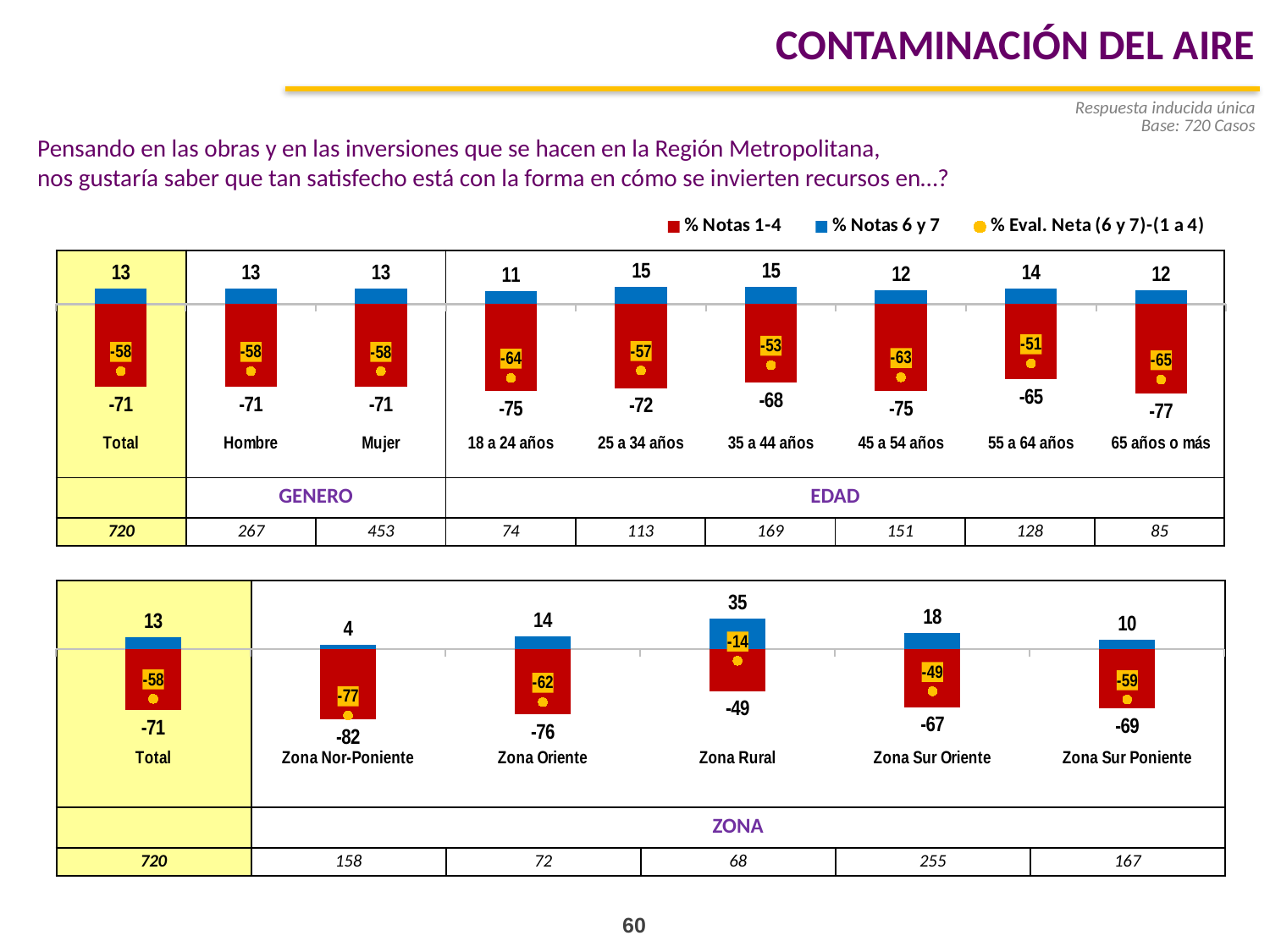
In the top chart (Género/Edad), which has a higher % Notas 6 y 7 value, 18 a 24 años or 55 a 64 años? 55 a 64 años In the bottom chart (Zona), what is the % Eval. Neta value for Zona Nor-Poniente? -77 In the top chart (Género/Edad), which age group has the lowest % Eval. Neta value? 65 años o más In the top chart (Género/Edad), what is the % Notas 6 y 7 value for 25 a 34 años? 15 In the top chart (Género/Edad), what is the % Eval. Neta value for 55 a 64 años? -51 In the bottom chart (Zona), which zone has the highest % Notas 6 y 7 value? Zona Rural How many series does the legend list? 3 How many zone categories (excluding Total) are shown in the bottom chart? 5 In the top chart (Género/Edad), what is the % Notas 1-4 value for 65 años o más? -77 In the bottom chart (Zona), what is the % Notas 6 y 7 value for Zona Rural? 35 In the bottom chart (Zona), which zone has the lowest % Notas 6 y 7 value? Zona Nor-Poniente In the bottom chart (Zona), what is the difference between the % Notas 6 y 7 values for Zona Rural and Zona Sur Oriente? 17